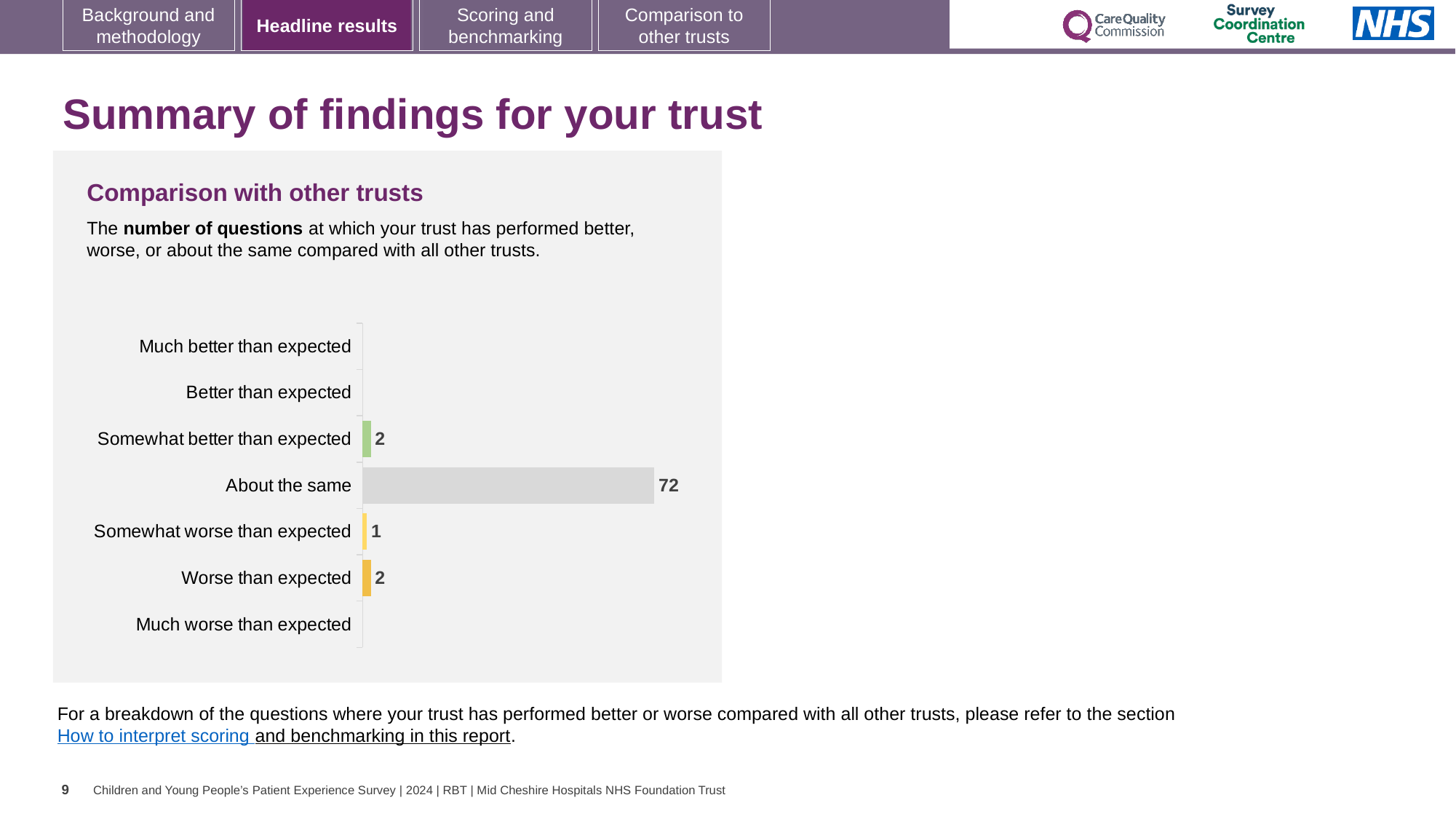
What is the value for 'Worse than expected'? 2 What kind of chart is shown on the slide? Bar chart What is the total of the 'Somewhat worse than expected' and 'Worse than expected' values? 3 What is the value for 'Somewhat worse than expected'? 1 Which category has the highest number of questions? About the same How many questions are in the 'About the same' category? 72 What is the title of the chart? Comparison with other trusts How many categories are listed on the chart's axis? 7 Which is larger: the value for 'Worse than expected' or the value for 'Somewhat worse than expected'? Worse than expected What colour is the bar for 'Somewhat better than expected'? Green What is the value for 'Somewhat better than expected'? 2 What is the difference between the 'About the same' value and the 'Somewhat better than expected' value? 70